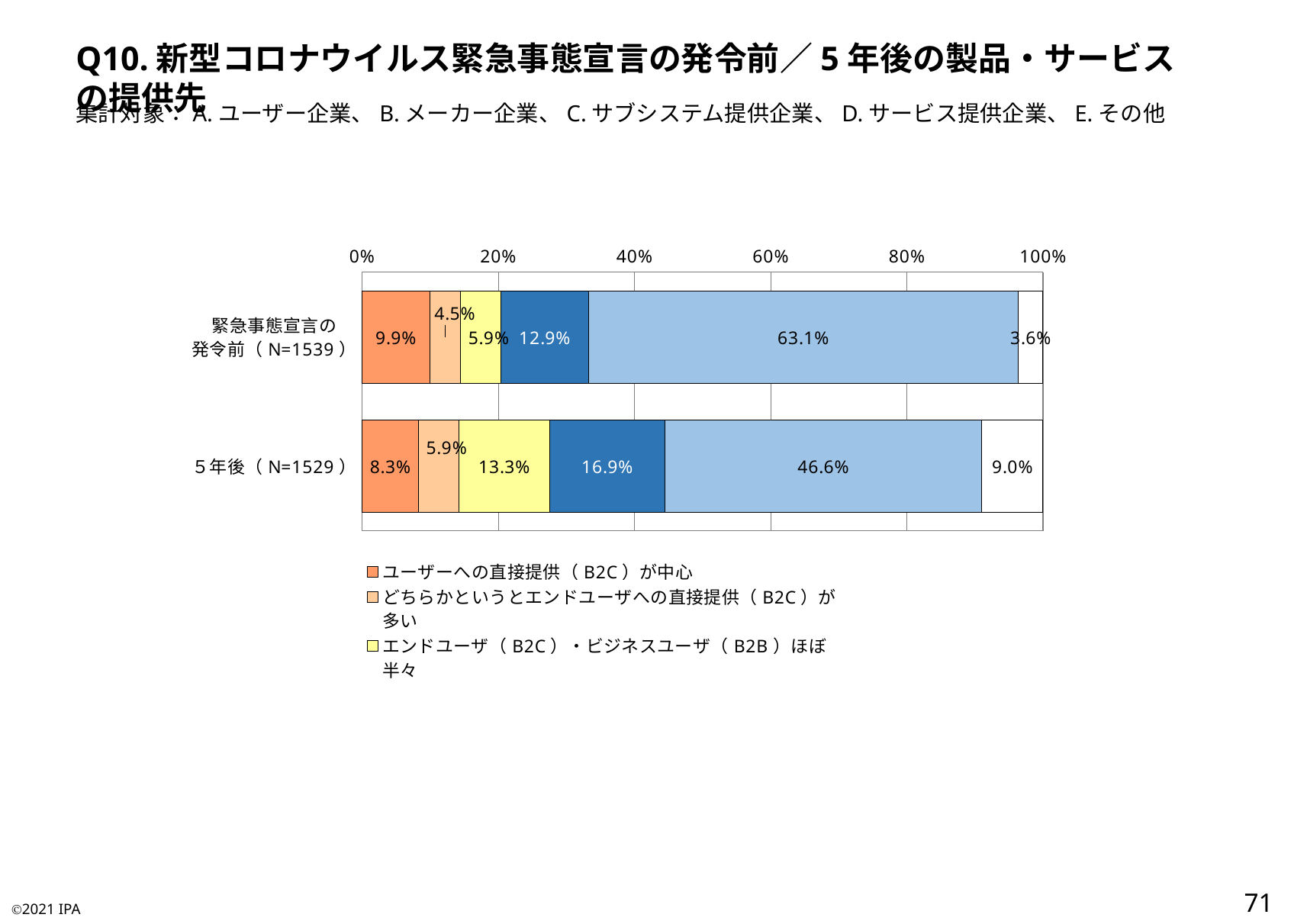
Does the value of ユーザーへの直接提供（B2C）が中心 rise or fall from 緊急事態宣言の発令前 to 5年後? Fall What is the value of ユーザーへの直接提供（B2C）が中心 for 5年後（N=1529）? 8.3% What is the difference in ユーザーへの直接提供（B2C）が中心 between 緊急事態宣言の発令前 and 5年後? 1.6 percentage points What is the value of the largest segment in the 5年後（N=1529）bar? 46.6% What is the value of エンドユーザ（B2C）・ビジネスユーザ（B2B）ほぼ半々 for 5年後（N=1529）? 13.3% What kind of chart is shown on the slide? Stacked bar chart What is the value of ユーザーへの直接提供（B2C）が中心 for 緊急事態宣言の発令前（N=1539）? 9.9% What is the difference in エンドユーザ（B2C）・ビジネスユーザ（B2B）ほぼ半々 between 5年後 and 緊急事態宣言の発令前? 7.4 percentage points How many bars (categories) are shown in the chart? 2 What is the value of どちらかというとエンドユーザへの直接提供（B2C）が多い for 緊急事態宣言の発令前（N=1539）? 4.5% Which has the larger value for エンドユーザ（B2C）・ビジネスユーザ（B2B）ほぼ半々, 緊急事態宣言の発令前 or 5年後? 5年後 What is the value of the largest segment in the 緊急事態宣言の発令前（N=1539）bar? 63.1%